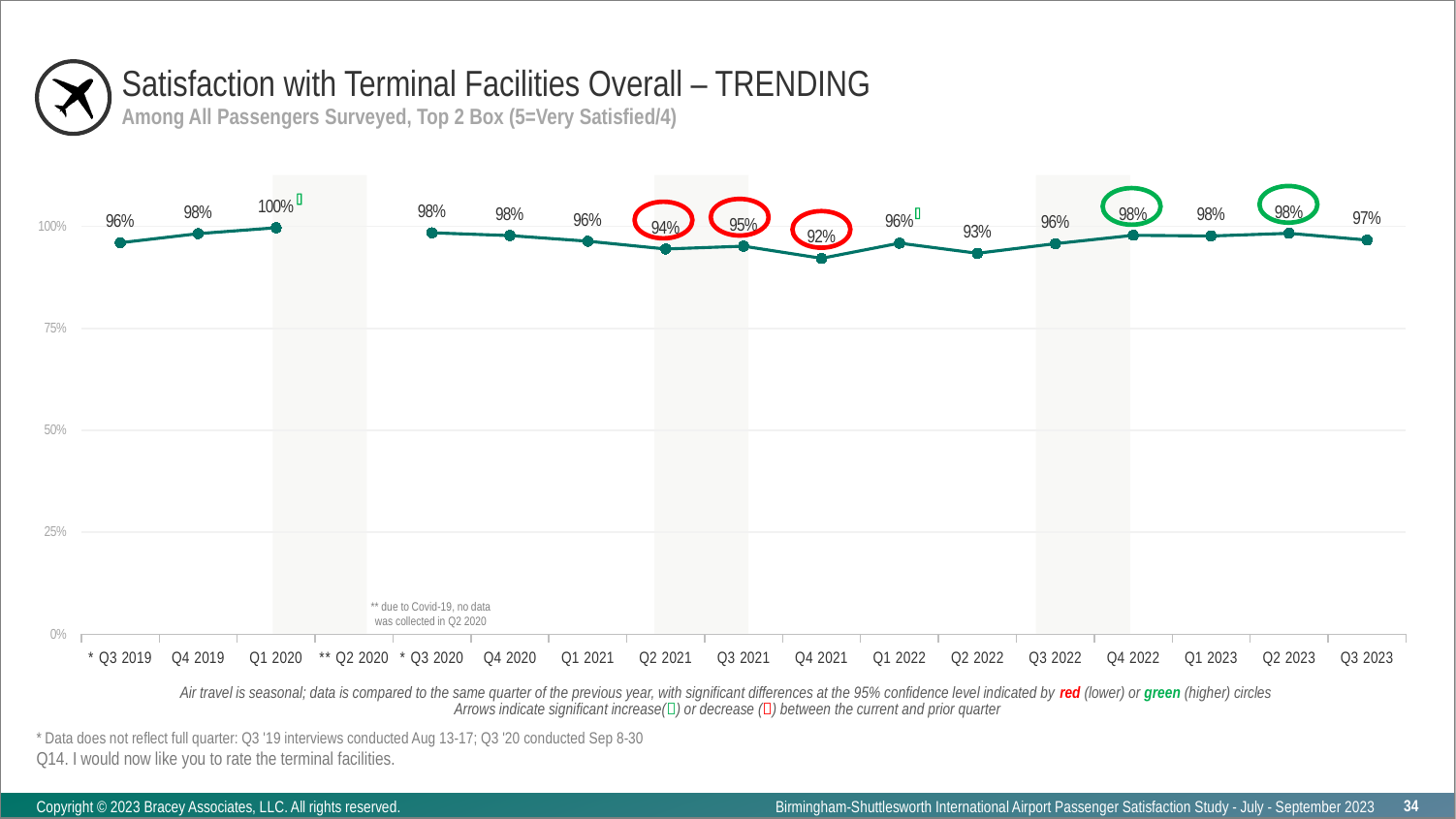
Is the value for Q2 2021 greater or less than 75%? greater Which is larger, the value for Q2 2022 or the value for Q3 2022? Q3 2022 Which quarter has the lowest satisfaction value? Q4 2021 How many quarters have a data point plotted on the chart? 16 What kind of chart is shown on the slide? Line chart What is the difference between the Q1 2020 value and the Q4 2021 value? 8 percentage points What is the satisfaction value for Q3 2023? 97% Which quarter on the x axis has no data collected due to Covid-19? Q2 2020 What is the satisfaction value for Q1 2020? 100% What is the difference between the Q4 2022 value and the Q3 2022 value? 2 percentage points Which quarter has the highest satisfaction value? Q1 2020 What is the satisfaction value for Q4 2021? 92%